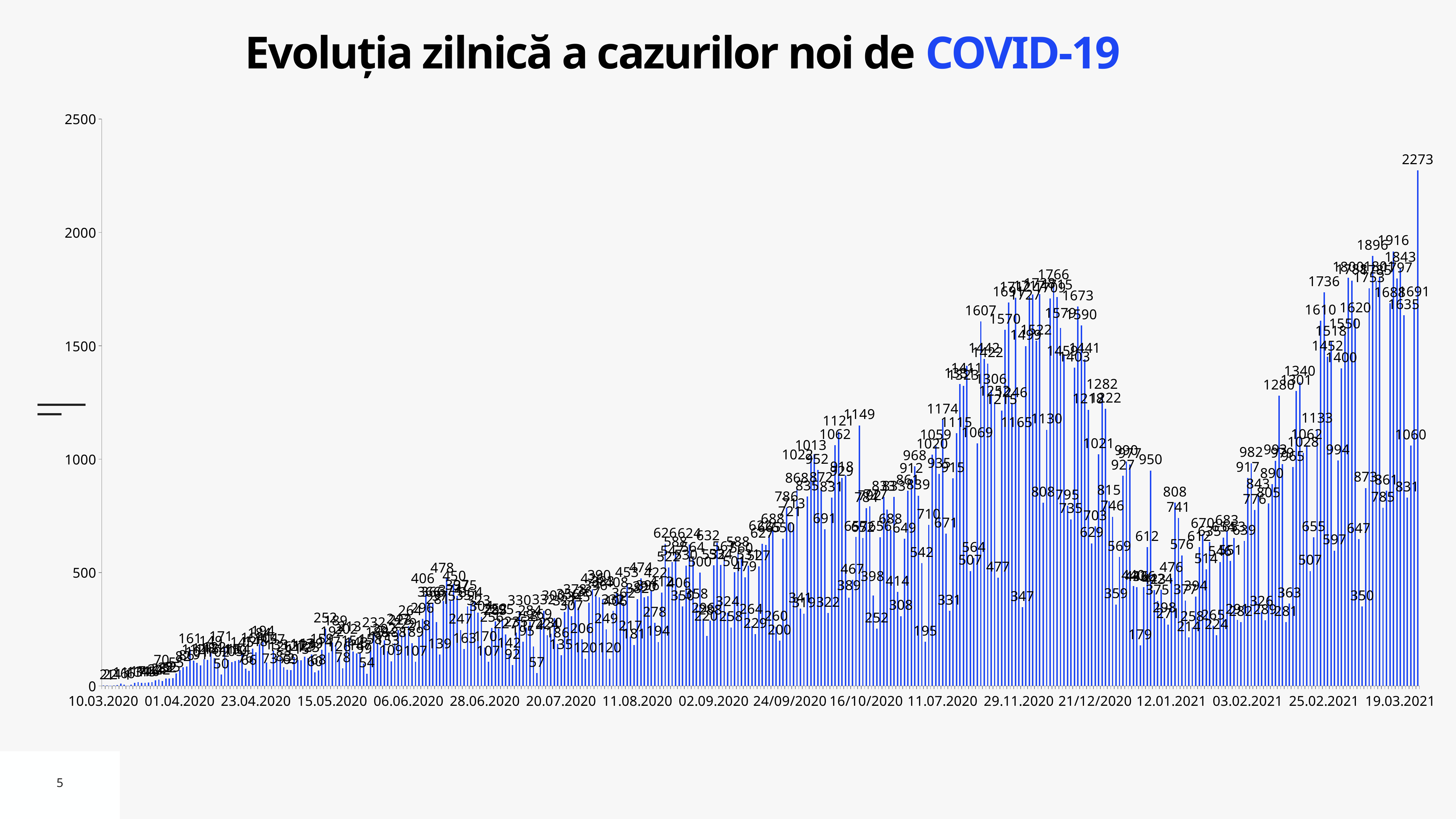
What is the highest daily value labelled on the chart? 2273 What is the maximum value shown on the vertical axis? 2500 What is the last date label on the horizontal axis? 19.03.2021 How many date labels are shown on the horizontal axis? 18 What is the first date label on the horizontal axis? 10.03.2020 Are the bars near 10.03.2020 greater or less than 500? less Is the tallest bar on the chart greater or less than 2000? greater What is the title of the chart? Evoluția zilnică a cazurilor noi de COVID-19 Overall, do the daily values rise or fall from 10.03.2020 to 19.03.2021? rise What is the difference between the final peak of 2273 and the late-2020 peak of 1766? 507 What kind of chart is shown on the slide? bar chart Which is larger: the late-2020 peak labelled 1766 or the final peak labelled 2273? 2273